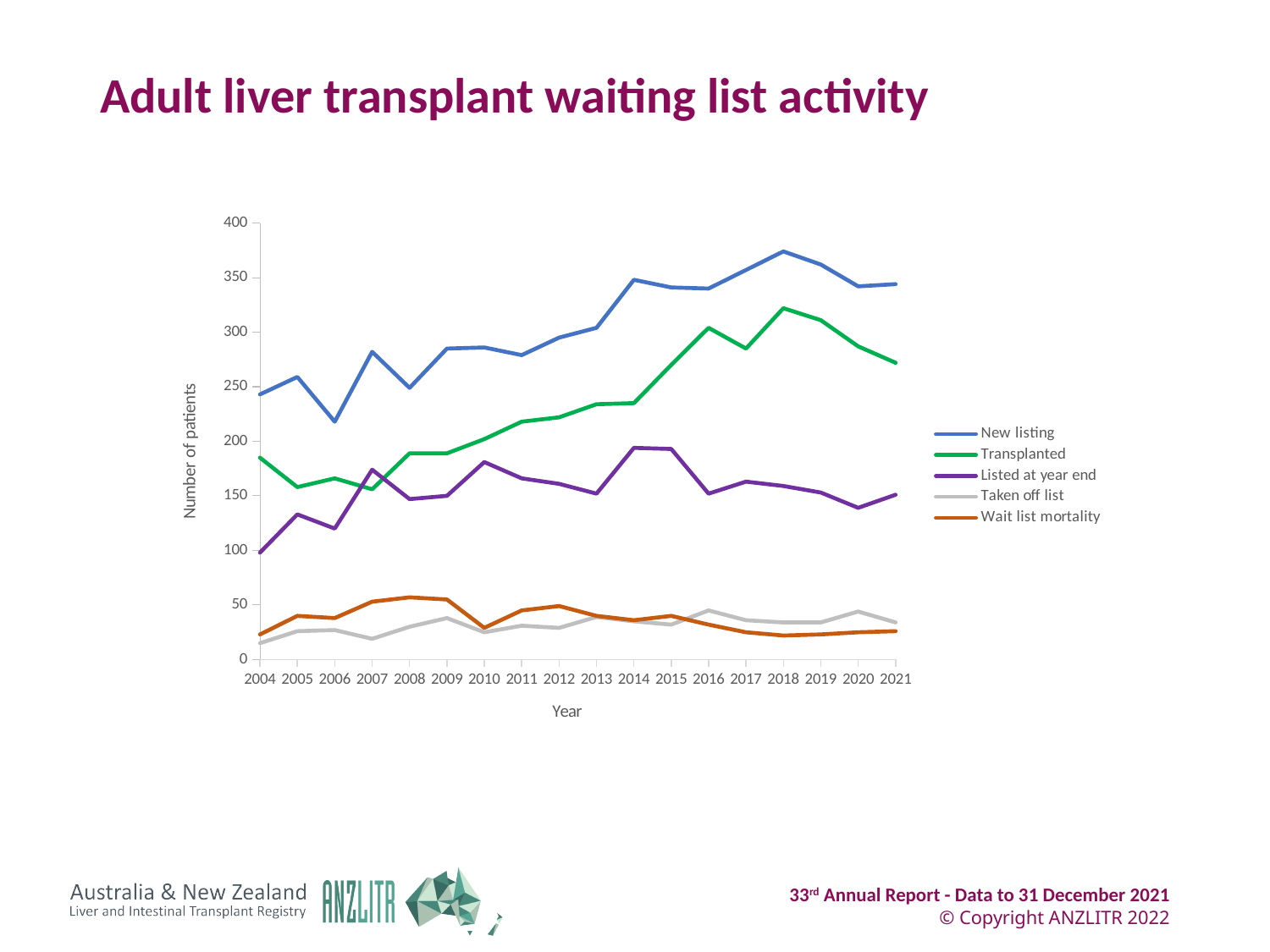
Which series has the larger value in 2021, New listing or Transplanted? New listing Is the value for Transplanted in 2004 greater or less than 200? less How many years are plotted along the x axis? 18 In which year is the New listing series at its lowest value? 2006 In which year is the Listed at year end series at its lowest value? 2004 What is the label on the vertical axis? Number of patients In which year does the Transplanted series reach its highest value? 2018 How many series does the legend list? 5 In which year does the New listing series reach its highest value? 2018 What kind of chart is shown on the slide? Line chart Overall, does the New listing series rise or fall from 2004 to 2021? Rise Is the value for New listing in 2018 greater or less than 350? greater